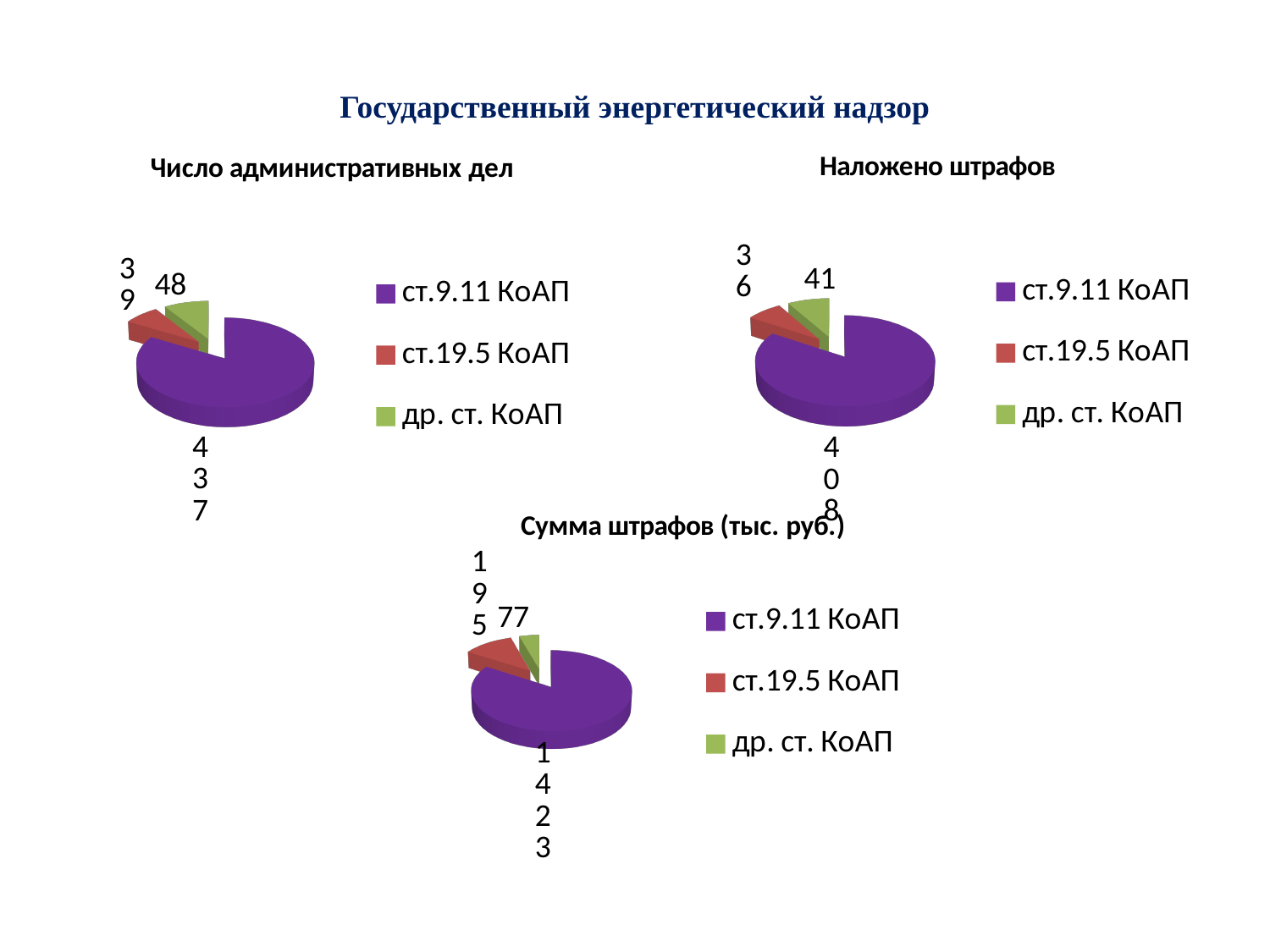
In the chart 'Сумма штрафов (тыс. руб.)', what is the value for ст.19.5 КоАП? 195 What type of chart is 'Число административных дел'? Pie chart How many charts are shown on the slide? 3 In the chart 'Наложено штрафов', which category has the largest slice? ст.9.11 КоАП In the chart 'Сумма штрафов (тыс. руб.)', what is the value for ст.9.11 КоАП? 1423 In the chart 'Число административных дел', what is the value for ст.9.11 КоАП? 437 In the chart 'Число административных дел', what is the value for др. ст. КоАП? 48 In the chart 'Наложено штрафов', what is the difference between the values for др. ст. КоАП and ст.19.5 КоАП? 5 How many categories does the legend of the chart 'Наложено штрафов' list? 3 In the chart 'Наложено штрафов', what is the value for ст.19.5 КоАП? 36 In the chart 'Число административных дел', which category has the smallest slice? ст.19.5 КоАП In the chart 'Сумма штрафов (тыс. руб.)', which is larger: ст.19.5 КоАП or др. ст. КоАП? ст.19.5 КоАП